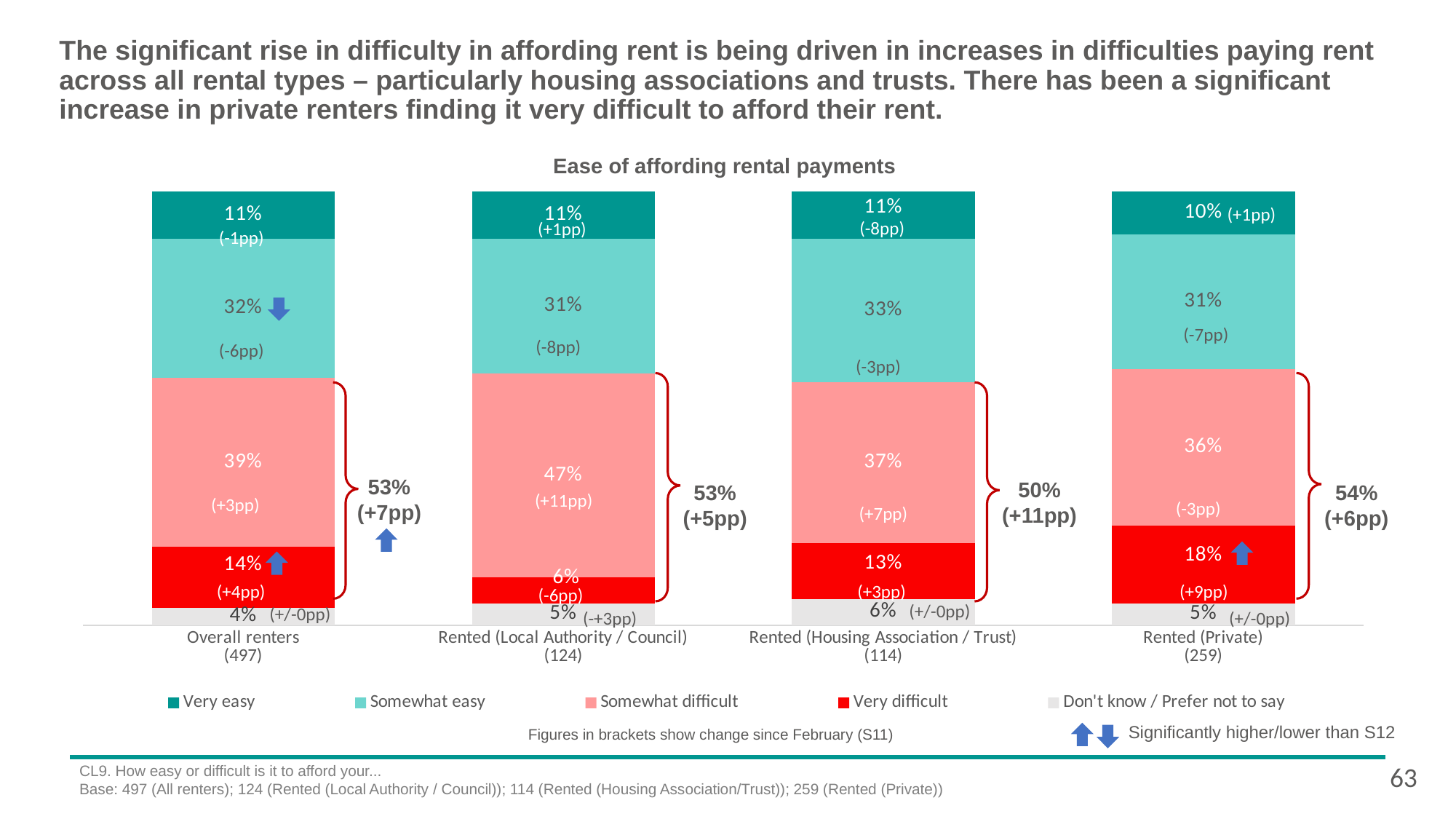
What kind of chart is shown on the slide? Stacked bar chart Which rental category has the highest 'Very difficult' percentage? Rented (Private) How many rental categories are shown along the x axis? 4 What is the difference between the 'Very difficult' percentages for Rented (Private) and Overall renters? 4 percentage points What percentage of Rented (Local Authority / Council) respondents find it somewhat difficult to afford their rent? 47% What is the chart's title? Ease of affording rental payments What is the 'Somewhat easy' value for Rented (Housing Association / Trust)? 33% Which rental category has the lowest 'Very difficult' percentage? Rented (Local Authority / Council) What is the combined 'Somewhat difficult' and 'Very difficult' total shown for Rented (Housing Association / Trust)? 50% What percentage of Rented (Private) respondents find it very difficult to afford their rent? 18% How many series does the legend list? 5 Which is larger: the 'Somewhat difficult' value for Overall renters or for Rented (Housing Association / Trust)? Overall renters